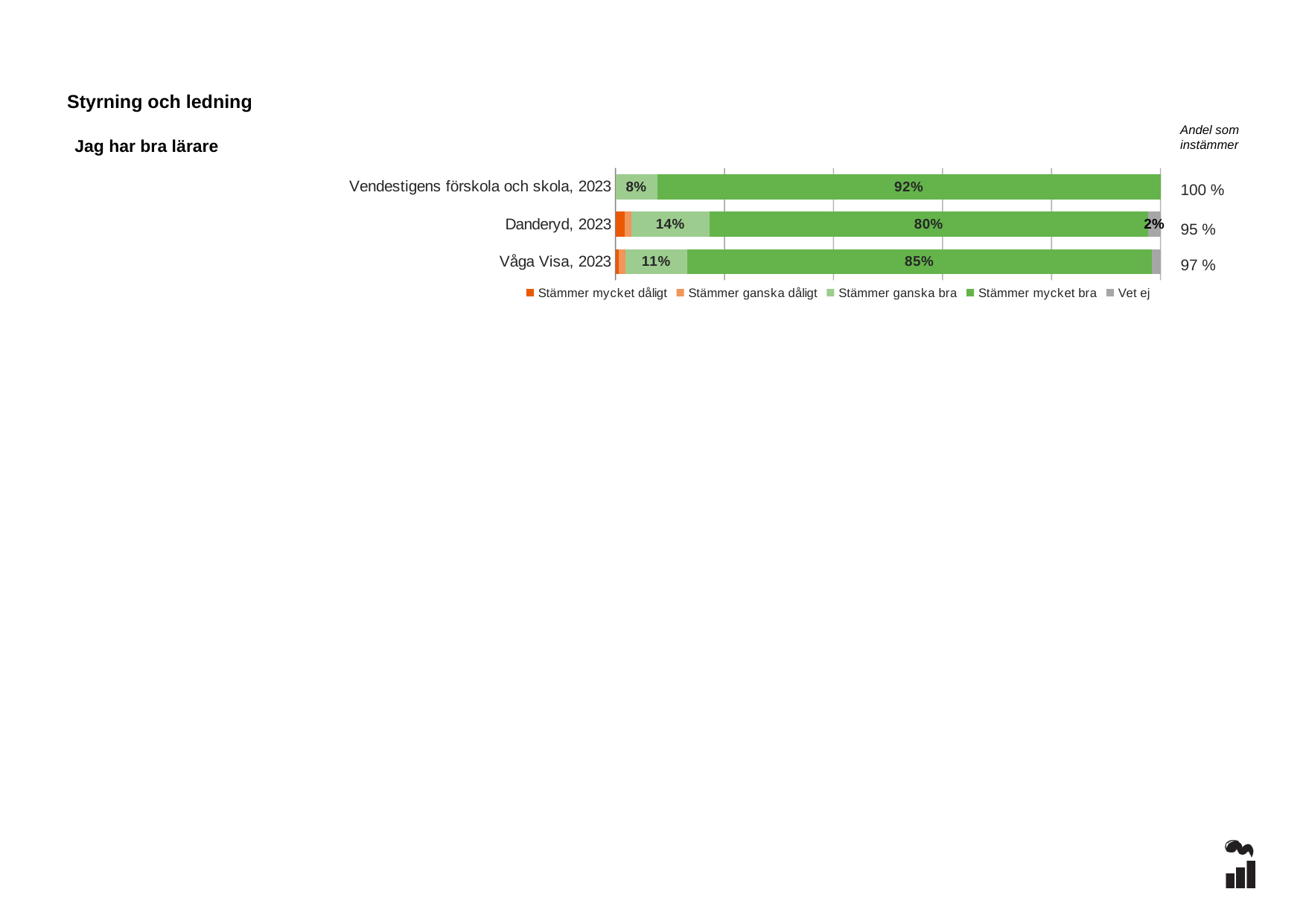
What is the 'Stämmer mycket bra' value for Våga Visa, 2023? 85% Which category has the highest 'Stämmer mycket bra' value? Vendestigens förskola och skola, 2023 What is the 'Andel som instämmer' value shown for Vendestigens förskola och skola, 2023? 100 % What kind of chart is shown on the slide? Stacked bar chart What is the 'Vet ej' value for Danderyd, 2023? 2% What is the difference between the 'Stämmer mycket bra' values for Vendestigens förskola och skola, 2023 and Danderyd, 2023? 12% Which category has the lowest 'Stämmer ganska bra' value? Vendestigens förskola och skola, 2023 How many series does the legend list? 5 Which is larger: the 'Stämmer ganska bra' value for Danderyd, 2023 or for Våga Visa, 2023? Danderyd, 2023 What is the 'Stämmer mycket bra' value for Vendestigens förskola och skola, 2023? 92% How many categories (bars) are shown in the chart? 3 What is the 'Stämmer ganska bra' value for Danderyd, 2023? 14%